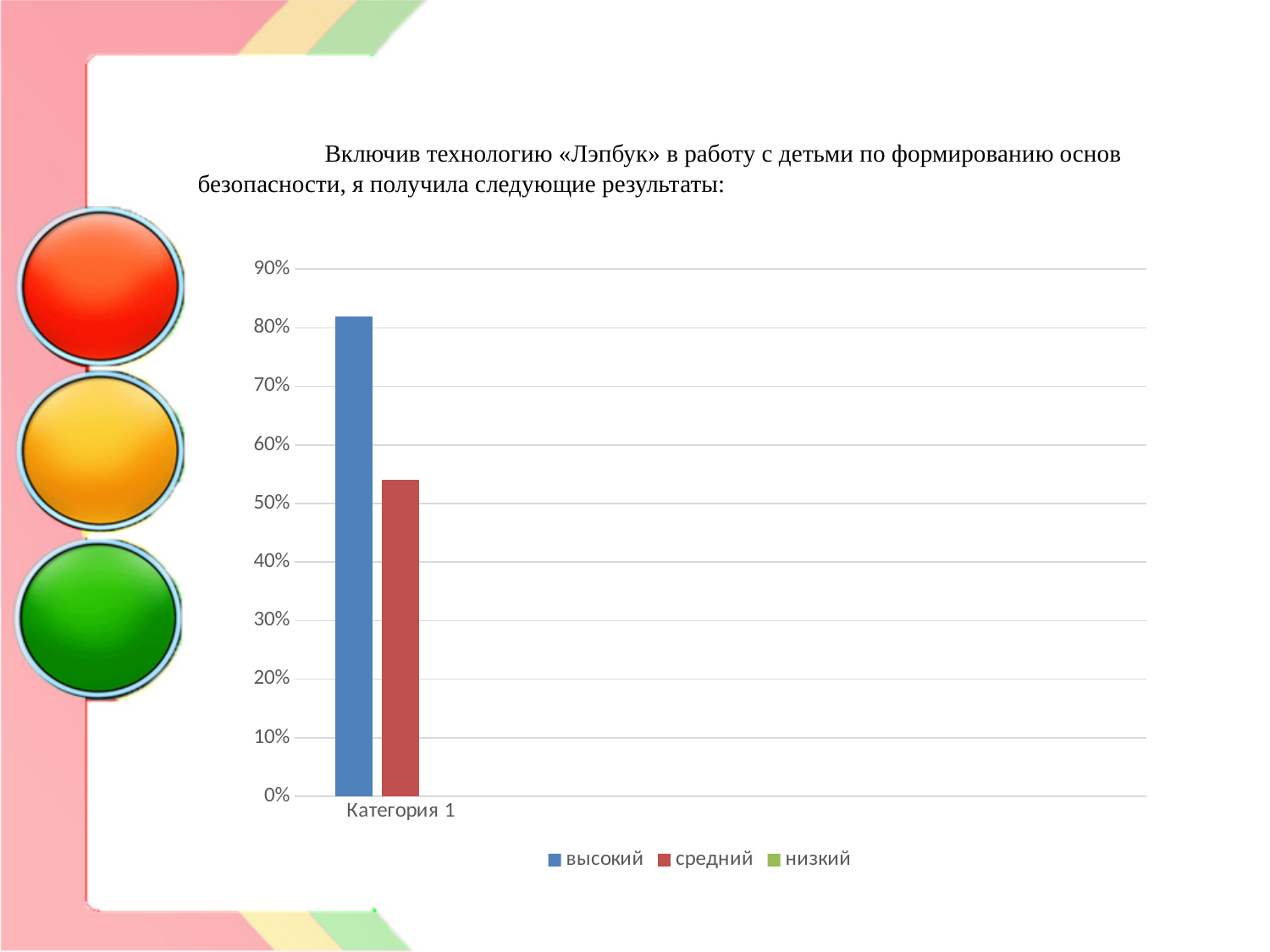
How many categories are shown on the x axis of the chart? 1 Is the value for средний greater or less than 60%? less What is the label of the single category on the x axis? Категория 1 Is the value for высокий greater or less than 70%? greater Is the value for средний greater or less than 50%? greater What colour is the bar for the series высокий? blue How many series does the chart legend list? 3 Which is larger, the bar for высокий or the bar for средний? высокий Which series has the highest bar in the chart? высокий What kind of chart is shown on the slide? bar chart